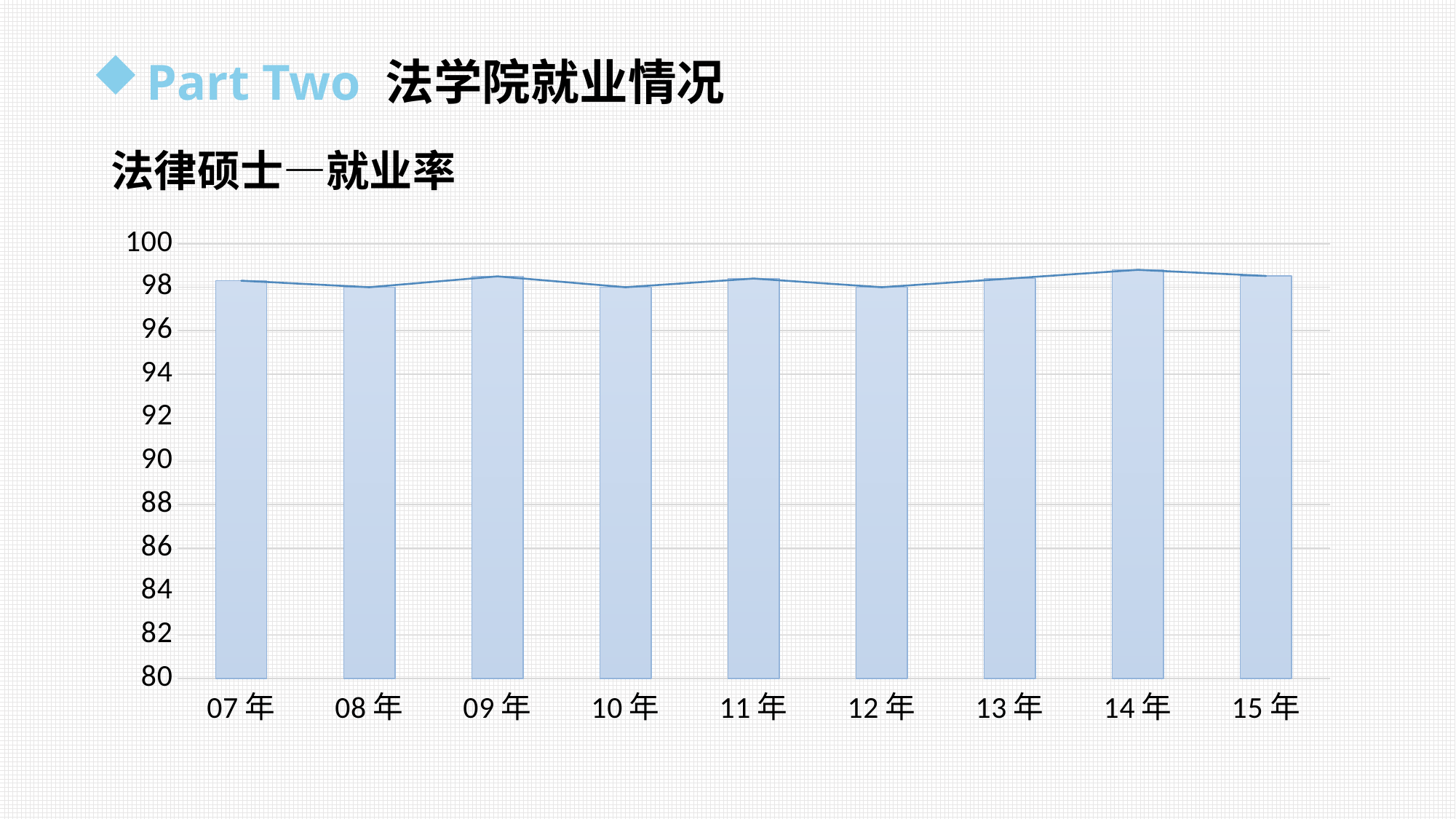
What kind of chart is shown on the slide? combination bar and line chart Is the value for 10年 greater or less than 90? greater How many years are shown on the x axis of the chart? 9 Is the value for 15年 greater or less than 96? greater What is the lowest value shown on the y axis of the chart? 80 Is the value for 09年 greater or less than 92? greater Which is the first year shown on the x axis of the chart? 07年 What is the title shown above the chart? 法律硕士—就业率